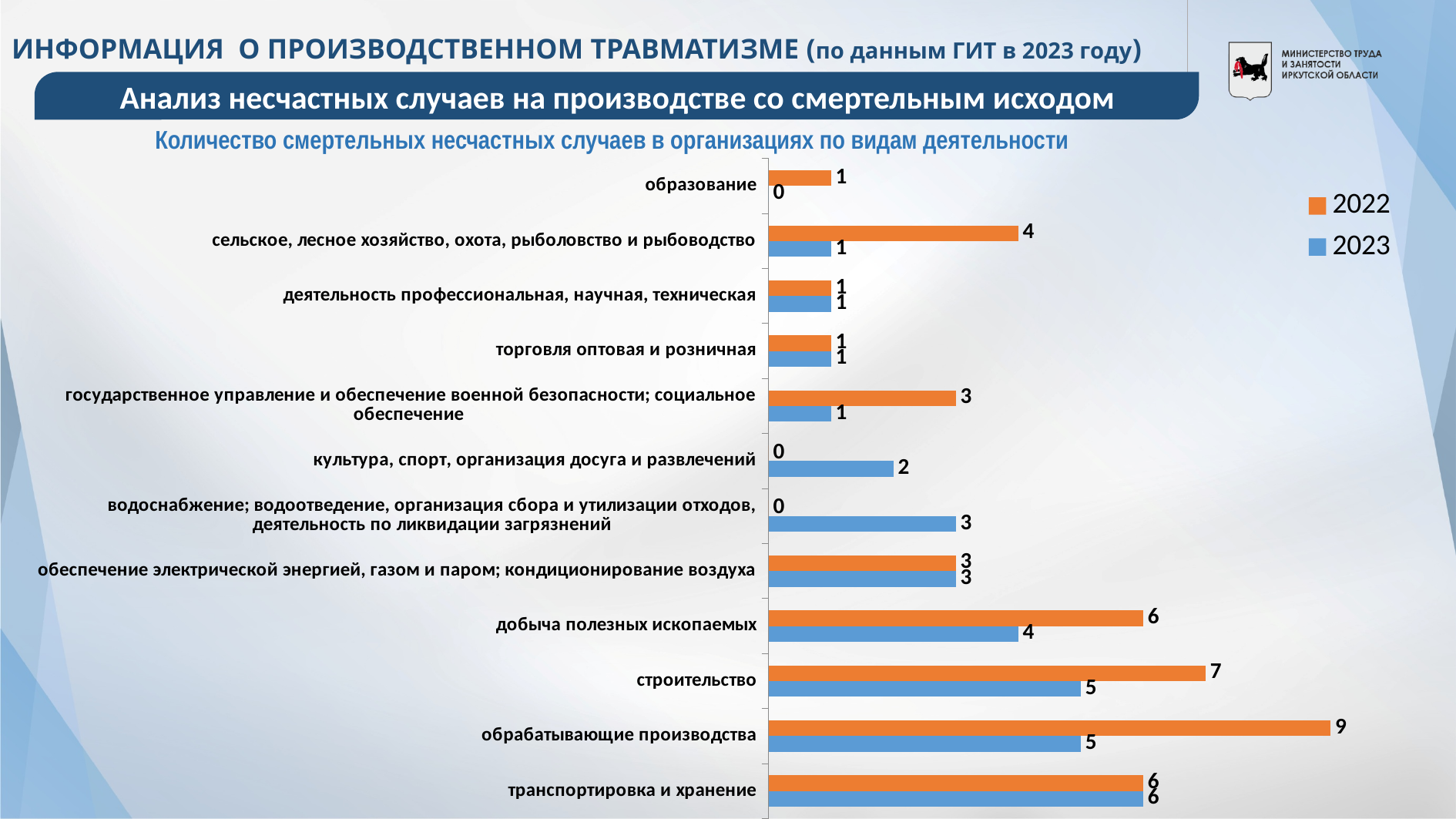
What type of chart is shown on the slide? bar chart How many series does the legend list? 2 Which category has the lowest 2023 value? образование Which is larger for добыча полезных ископаемых: the 2022 value or the 2023 value? 2022 What is the 2023 value for водоснабжение; водоотведение, организация сбора и утилизации отходов, деятельность по ликвидации загрязнений? 3 Which category has the highest 2022 value? обрабатывающие производства What is the 2022 value for обрабатывающие производства? 9 How many categories (types of activity) are shown in the chart? 12 What is the difference between the 2022 and 2023 values for обрабатывающие производства? 4 Which category has the highest 2023 value? транспортировка и хранение What is the 2023 value for строительство? 5 Which colour represents the 2023 series in the legend? blue